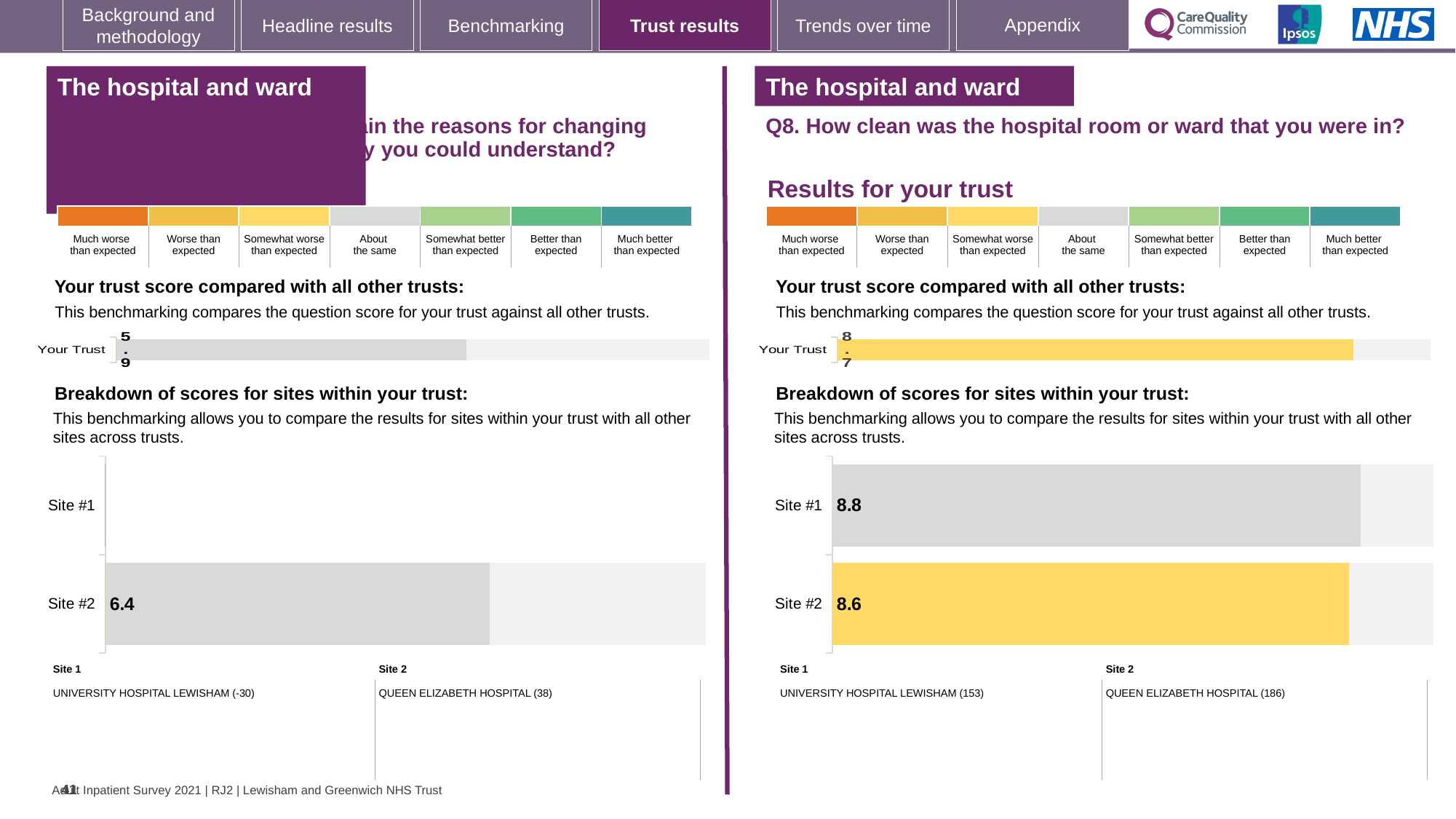
On the right-hand Q8 breakdown of scores for sites, what is the score for Site #1? 8.8 On the right-hand Q8 breakdown of scores for sites, which site has the higher score? Site #1 On the right-hand Q8 breakdown of scores for sites, what is the difference between the Site #1 and Site #2 scores? 0.2 On the right-hand Q8 breakdown of scores for sites, is the Site #2 score larger or smaller than the Site #1 score? Smaller On the left-hand chart, what is the score shown for Your Trust? 5.9 On the left-hand breakdown of scores for sites, what is the score for Site #2? 6.4 On the right-hand Q8 breakdown of scores for sites, what is the score for Site #2? 8.6 On the left-hand breakdown of scores for sites, how many sites are listed? 2 On the right-hand Q8 breakdown of scores for sites, what colour is the Site #1 bar? Grey What kind of chart is used for the breakdown of scores for sites on the right-hand side? Bar chart On the right-hand chart for Q8 (how clean was the hospital room or ward), what is the score shown for Your Trust? 8.7 On the right-hand Q8 breakdown of scores for sites, what colour is the Site #2 bar? Yellow